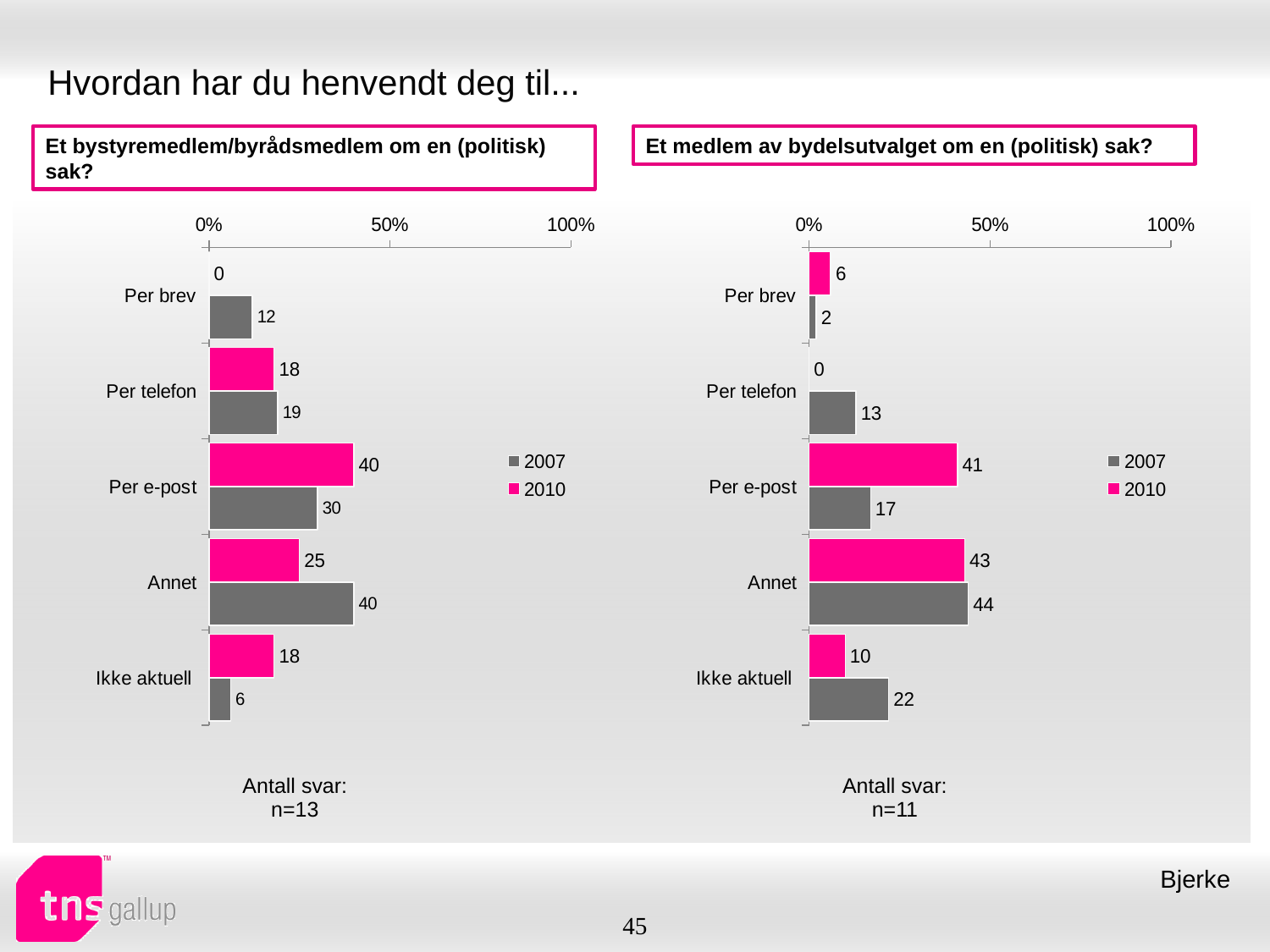
In the left chart (Et bystyremedlem/byrådsmedlem om en (politisk) sak?), which is larger for Annet: the 2007 value or the 2010 value? 2007 In the left chart (Et bystyremedlem/byrådsmedlem om en (politisk) sak?), what is the value for Per brev in 2007? 12 In the right chart (Et medlem av bydelsutvalget om en (politisk) sak?), what is the difference between the 2010 and 2007 values for Per e-post? 24 In the right chart (Et medlem av bydelsutvalget om en (politisk) sak?), what is the value for Ikke aktuell in 2010? 10 In the left chart (Et bystyremedlem/byrådsmedlem om en (politisk) sak?), which category has the highest value for 2007? Annet In the left chart (Et bystyremedlem/byrådsmedlem om en (politisk) sak?), what is the difference between the 2007 and 2010 values for Ikke aktuell? 12 In the left chart (Et bystyremedlem/byrådsmedlem om en (politisk) sak?), what is the value for Per e-post in 2010? 40 In the right chart (Et medlem av bydelsutvalget om en (politisk) sak?), is the 2007 value for Annet greater or less than 50%? less How many categories are shown in the left chart (Et bystyremedlem/byrådsmedlem om en (politisk) sak?)? 5 In the right chart (Et medlem av bydelsutvalget om en (politisk) sak?), what is the value for Per e-post in 2007? 17 How many series does the legend of the right chart (Et medlem av bydelsutvalget om en (politisk) sak?) list? 2 In the right chart (Et medlem av bydelsutvalget om en (politisk) sak?), which category has the lowest value for 2010? Per telefon